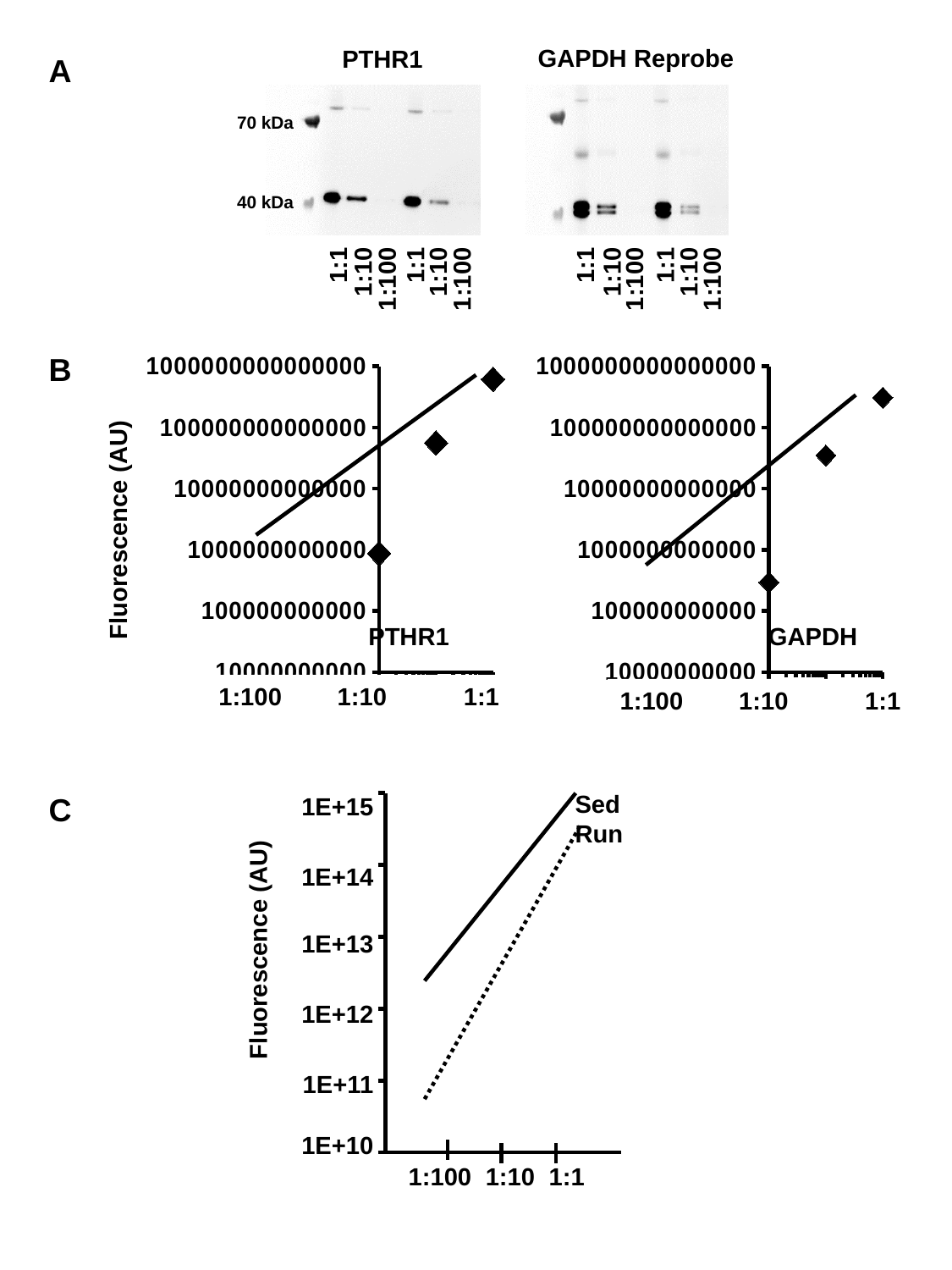
In panel C, what kind of chart is shown? line chart In panel C, is the Run value at 1:1 greater or less than 1E+14? greater In panel C, how many series (lines) are plotted? 2 In panel B, in the GAPDH chart, is the value at 1:10 greater or less than 1000000000000? less In panel B, what is the y-axis label of the charts? Fluorescence (AU) In panel C, at 1:100, which series has the higher fluorescence, Sed or Run? Sed In panel B, how many data points are plotted in the PTHR1 chart? 3 In panel C, is the Sed value at 1:100 greater or less than 1E+12? greater In panel C, which series is drawn with the dotted line? Run In panel C, do the Sed and Run lines rise or fall from 1:100 to 1:1? rise